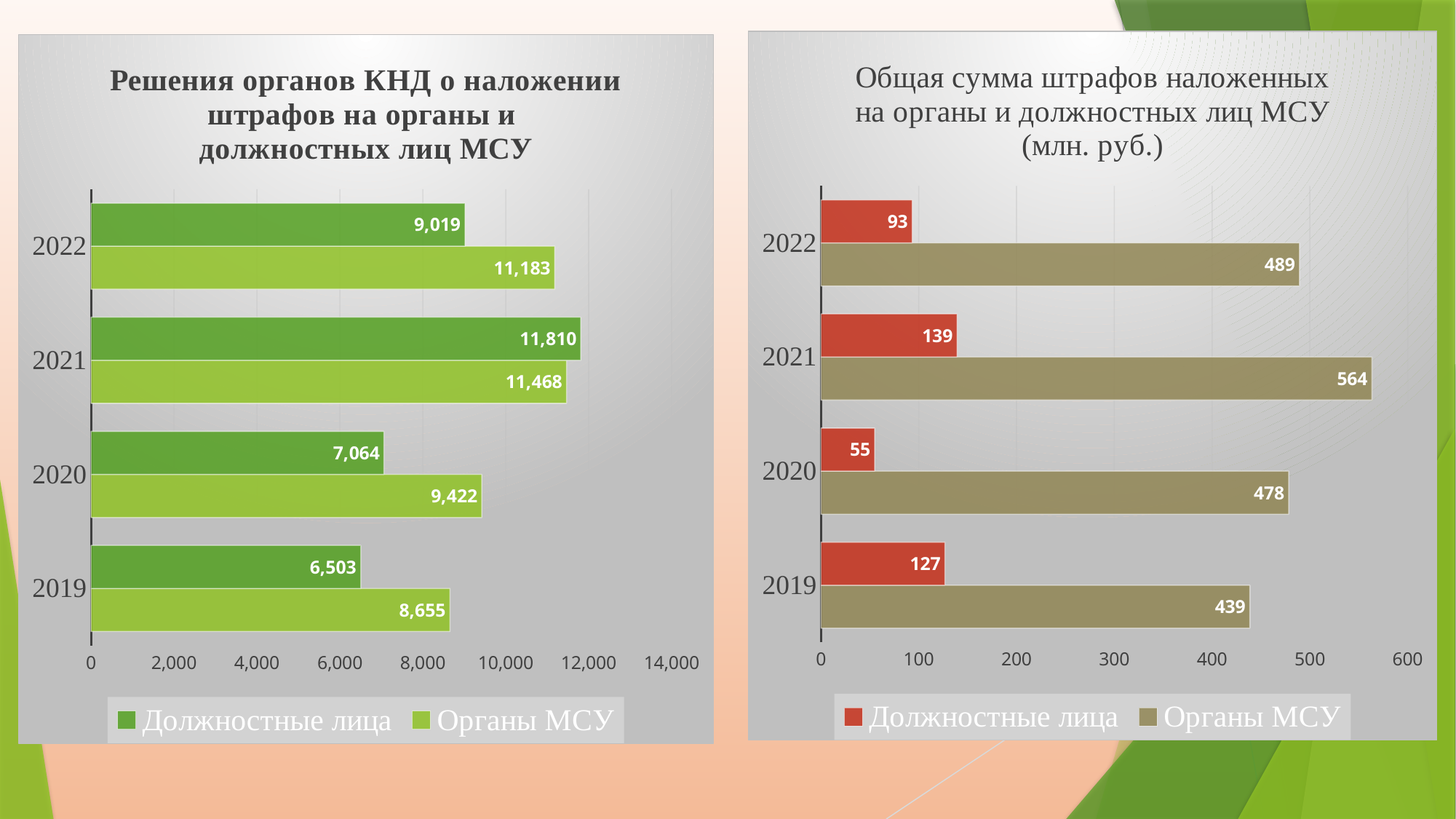
In the right chart (Общая сумма штрафов, млн. руб.), how many years are shown on the vertical axis? 4 In the left chart (Решения органов КНД о наложении штрафов), what is the value for Должностные лица in 2021? 11,810 In the left chart (Решения органов КНД о наложении штрафов), which is larger in 2022: Должностные лица or Органы МСУ? Органы МСУ What type of chart is the right chart (Общая сумма штрафов, млн. руб.)? Bar chart In the right chart (Общая сумма штрафов, млн. руб.), what is the difference between Органы МСУ and Должностные лица in 2019? 312 In the left chart (Решения органов КНД о наложении штрафов), which year has the lowest value for Должностные лица? 2019 In the right chart (Общая сумма штрафов, млн. руб.), what is the value for Должностные лица in 2020? 55 In the left chart (Решения органов КНД о наложении штрафов), how many series does the legend list? 2 In the left chart (Решения органов КНД о наложении штрафов), what is the value for Органы МСУ in 2019? 8,655 In the right chart (Общая сумма штрафов, млн. руб.), what is the value for Органы МСУ in 2021? 564 In the right chart (Общая сумма штрафов, млн. руб.), which year has the highest value for Органы МСУ? 2021 In the left chart (Решения органов КНД о наложении штрафов), what is the difference between Органы МСУ and Должностные лица in 2020? 2,358